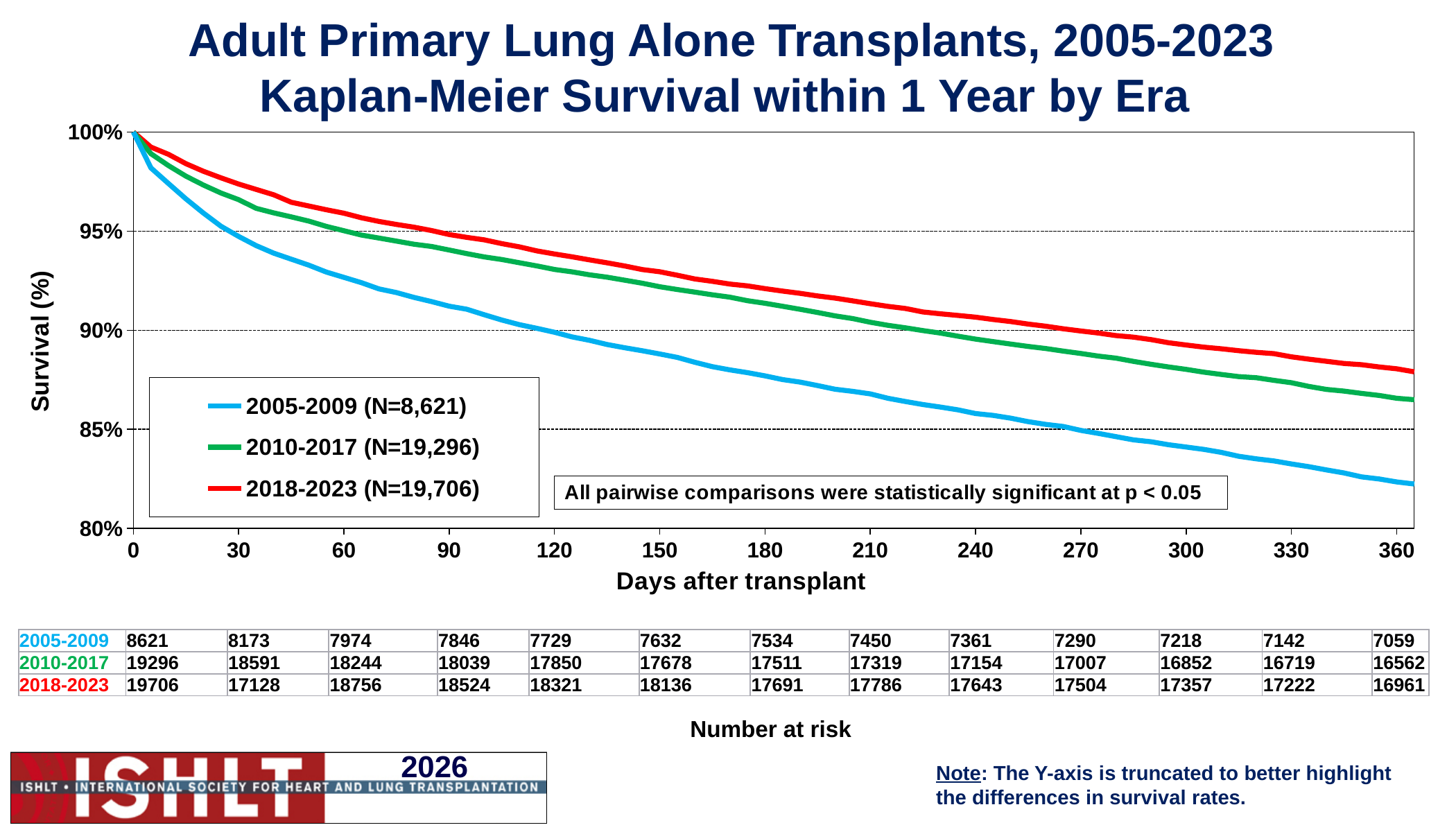
According to the number at risk table, how many patients were at risk in the 2018-2023 era at day 360? 16961 What is the difference between the number at risk at day 0 for the 2018-2023 era and the 2005-2009 era? 11085 According to the number at risk table, how many patients were at risk in the 2005-2009 era at day 0? 8621 Is the survival for the 2005-2009 era at 180 days greater or less than 90%? less Is the survival for the 2005-2009 era at 360 days greater or less than 85%? less Which era has the highest survival at 360 days after transplant? 2018-2023 What kind of chart is shown on the slide? line chart Is the survival for the 2018-2023 era at 180 days greater or less than 90%? greater Do the survival curves rise or fall as days after transplant increase? fall Which era has the lowest survival at 360 days after transplant? 2005-2009 What is the sample size (N) shown in the legend for the 2010-2017 era? 19,296 How many series does the legend list? 3